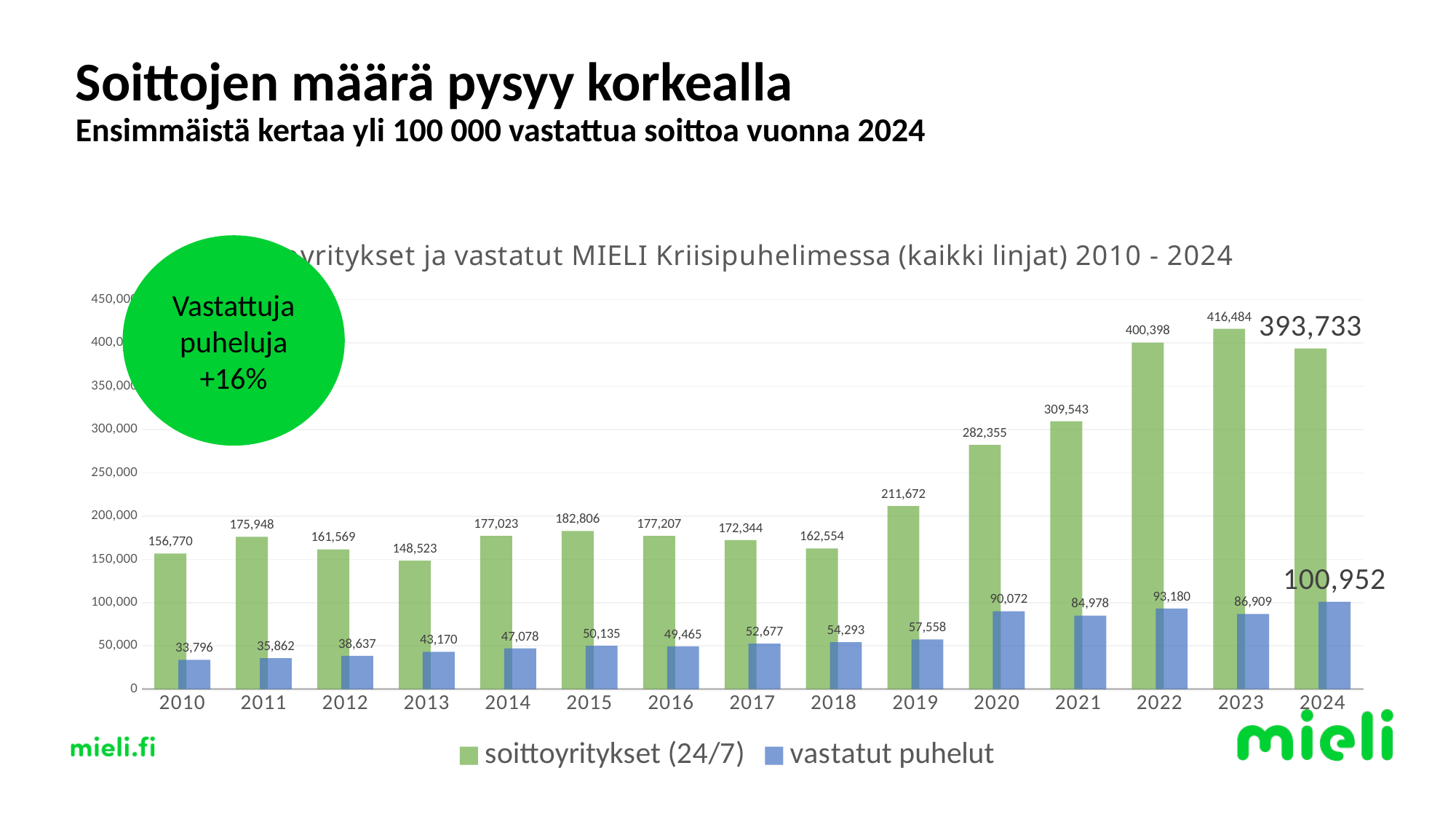
By how much did soittoyritykset (24/7) change from 2022 to 2023? 16,086 In which year is the vastatut puhelut value lowest? 2010 What is the value of vastatut puhelut for 2024? 100,952 What is the value of vastatut puhelut for 2015? 50,135 Do the vastatut puhelut values rise or fall from 2010 to 2019? Rise How many series does the legend list? 2 What kind of chart is shown on the slide? Bar chart What is the value of soittoyritykset (24/7) for 2020? 282,355 In which year is the soittoyritykset (24/7) value highest? 2023 How many years are shown on the x axis? 15 Which year has the larger soittoyritykset (24/7) value, 2011 or 2019? 2019 What is the difference between soittoyritykset (24/7) and vastatut puhelut in 2024? 292,781